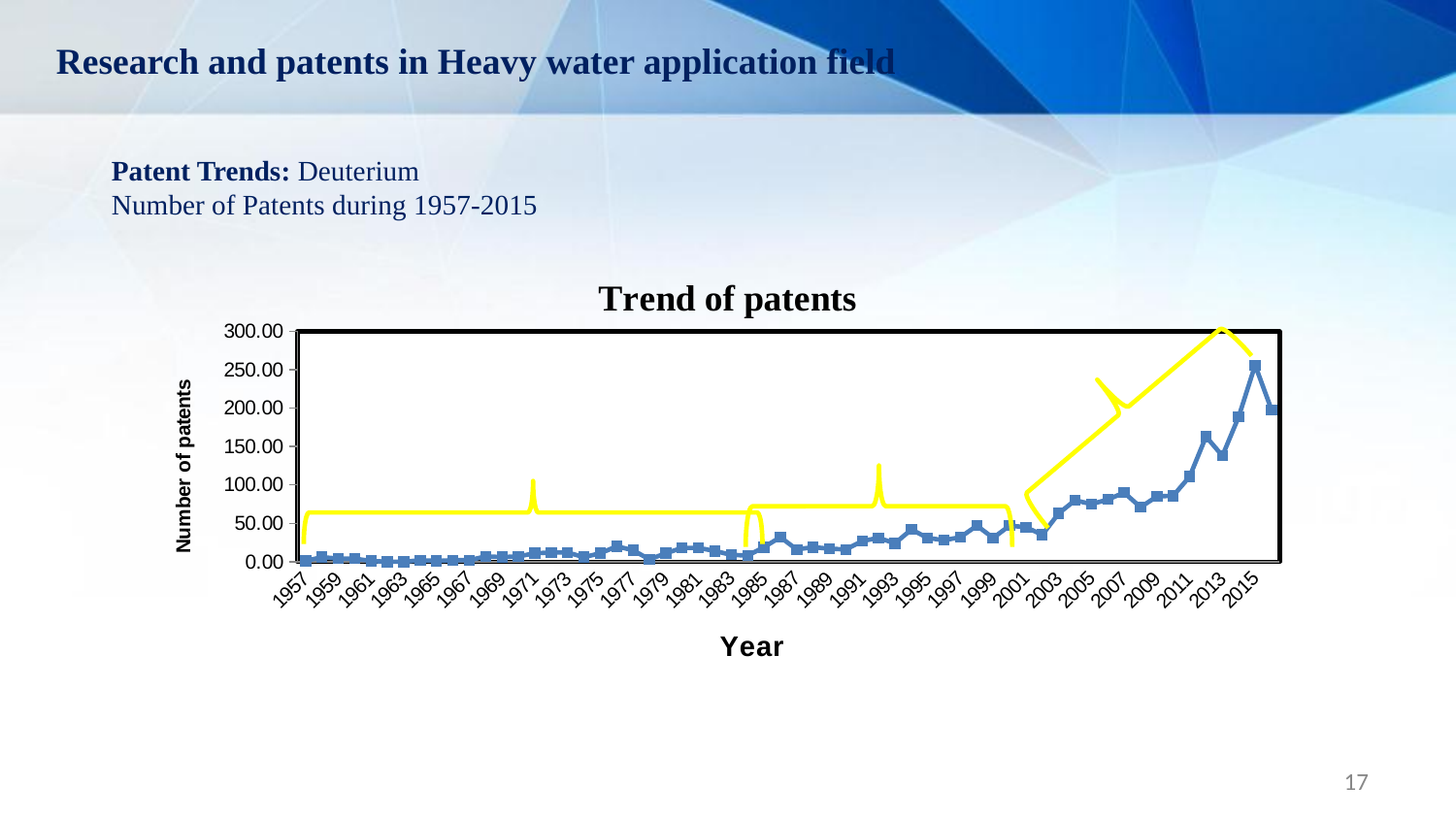
Which has the larger value, 1957 or 2015? 2015 Is the value for 1957 greater or less than 50? less What is the title of the chart? Trend of patents What is the highest tick value shown on the y-axis? 300.00 Is the highest value plotted on the chart greater or less than 300? less Overall, do the values in 'Trend of patents' rise or fall from 1957 to 2015? rise How many lines (data series) are plotted on the chart? 1 What is the label of the y-axis of the chart? Number of patents Is the value for 2015 greater or less than 150? greater What kind of chart is 'Trend of patents'? line chart